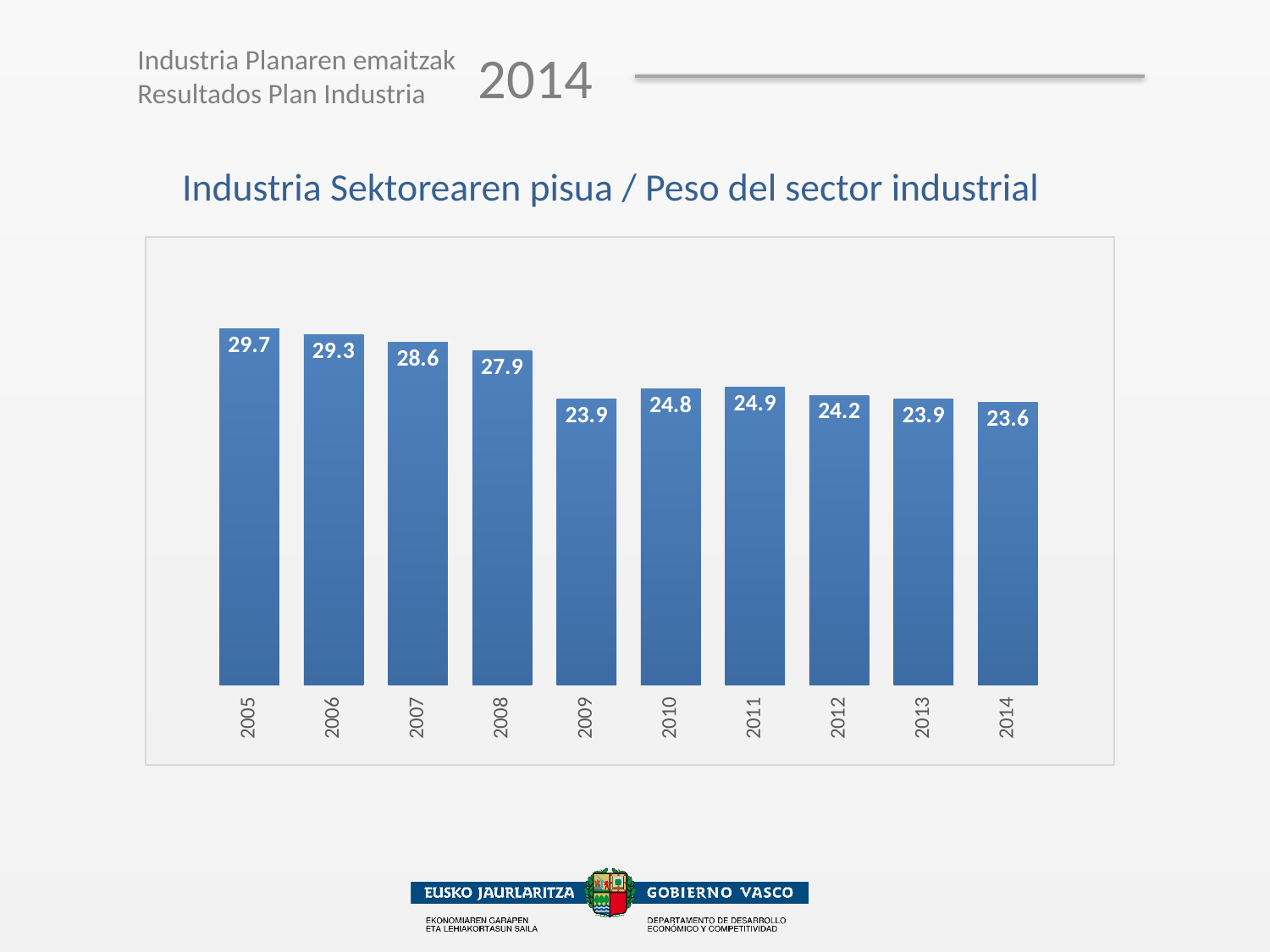
What is the title of the chart? Industria Sektorearen pisua / Peso del sector industrial What is the value for 2011? 24.9 What is the value for 2005? 29.7 How many years are shown on the x axis? 10 What is the value for 2014? 23.6 Which year has the lowest value? 2014 What kind of chart is shown on the slide? Bar chart Which is larger, the value for 2010 or the value for 2012? 2010 What is the value for 2009? 23.9 What is the difference between the values for 2008 and 2009? 4.0 What is the difference between the values for 2005 and 2014? 6.1 Which year has the highest value? 2005